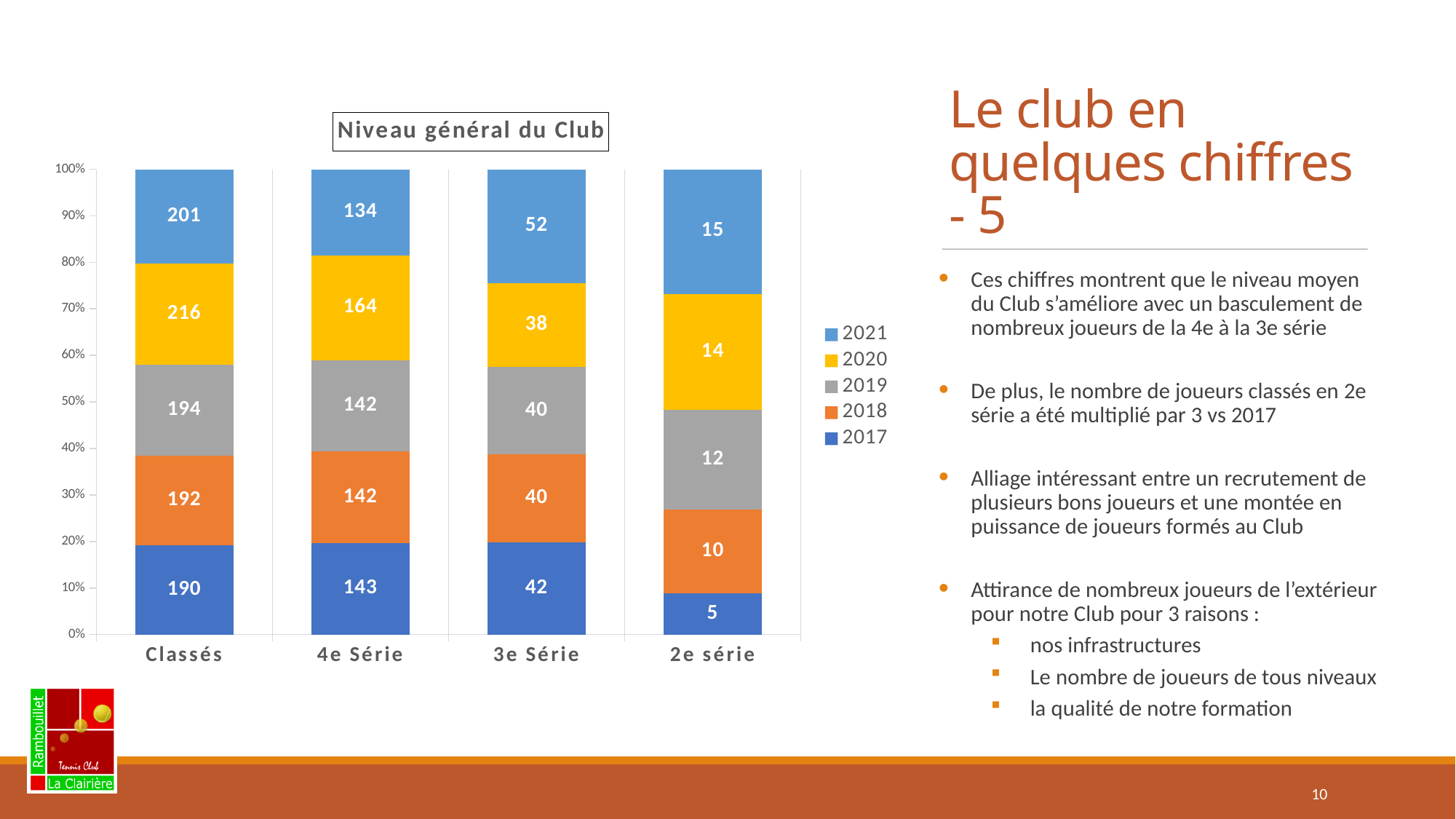
Which is larger in the 4e Série category: the 2020 value or the 2021 value? 2020 How many series does the legend list? 5 Which year has the highest value in the 3e Série category? 2021 What is the total of all values in the 2e série bar? 56 Which year has the lowest value in the 2e série category? 2017 What is the title of the chart? Niveau général du Club What is the value for 2021 in the Classés category? 201 How many categories are shown on the x axis? 4 What kind of chart is shown? Stacked bar chart What is the value for 2020 in the 4e Série category? 164 What is the value for 2017 in the 2e série category? 5 What is the difference between the 2021 and 2017 values in the 2e série category? 10